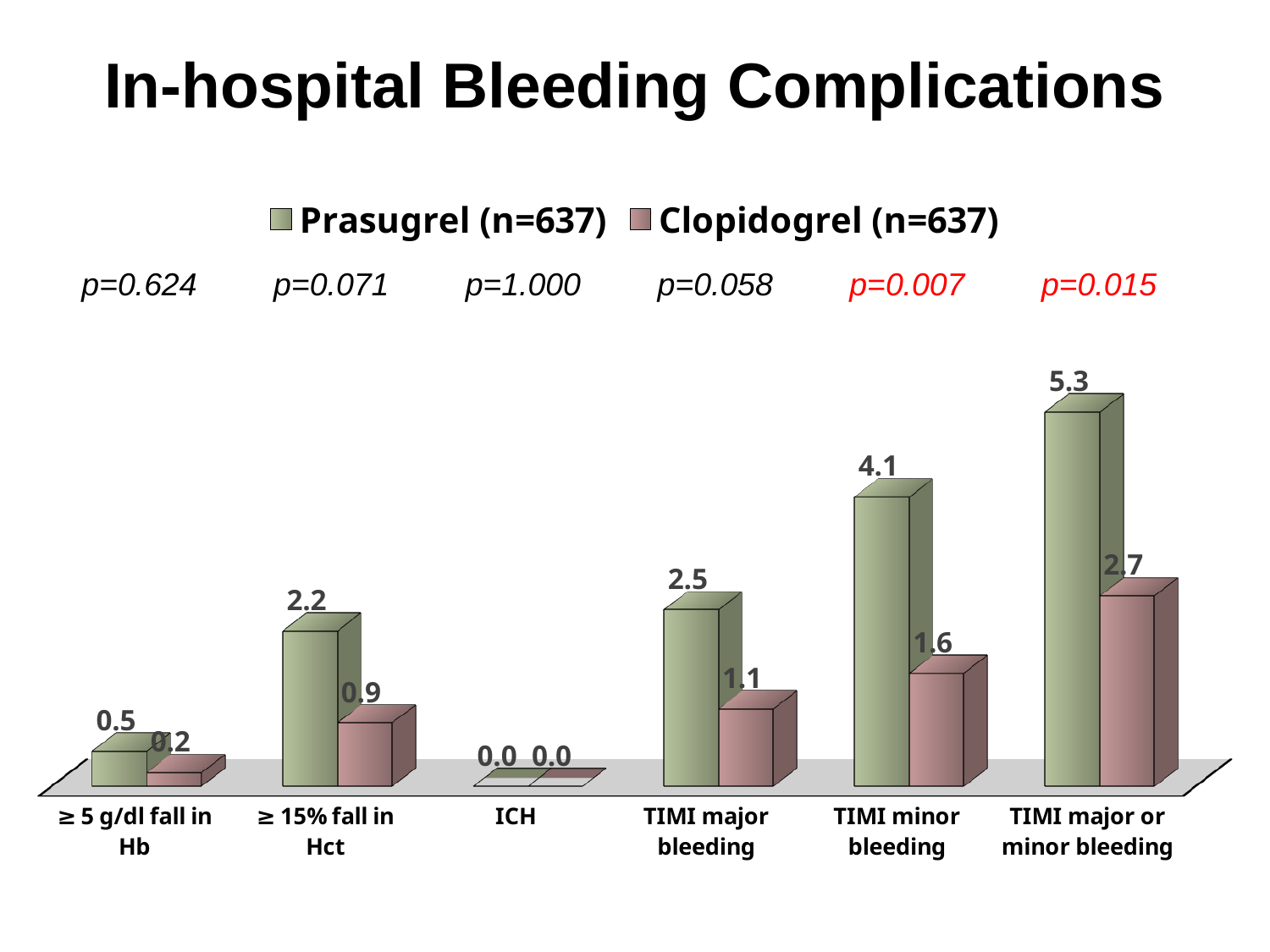
How many series does the legend list? 2 What p-value is shown above the TIMI minor bleeding category? p=0.007 What is the Prasugrel value for ≥ 15% fall in Hct? 2.2 Which category has the lowest Clopidogrel value? ICH How many categories are shown on the x axis? 6 Which category has the highest Prasugrel value? TIMI major or minor bleeding Which is larger for TIMI minor bleeding, the Prasugrel value or the Clopidogrel value? Prasugrel What is the Clopidogrel value for TIMI minor bleeding? 1.6 What kind of chart is shown on the slide? Bar chart What is the title of the slide? In-hospital Bleeding Complications What is the Prasugrel value for TIMI major bleeding? 2.5 What is the difference between the Prasugrel and Clopidogrel values for TIMI major or minor bleeding? 2.6